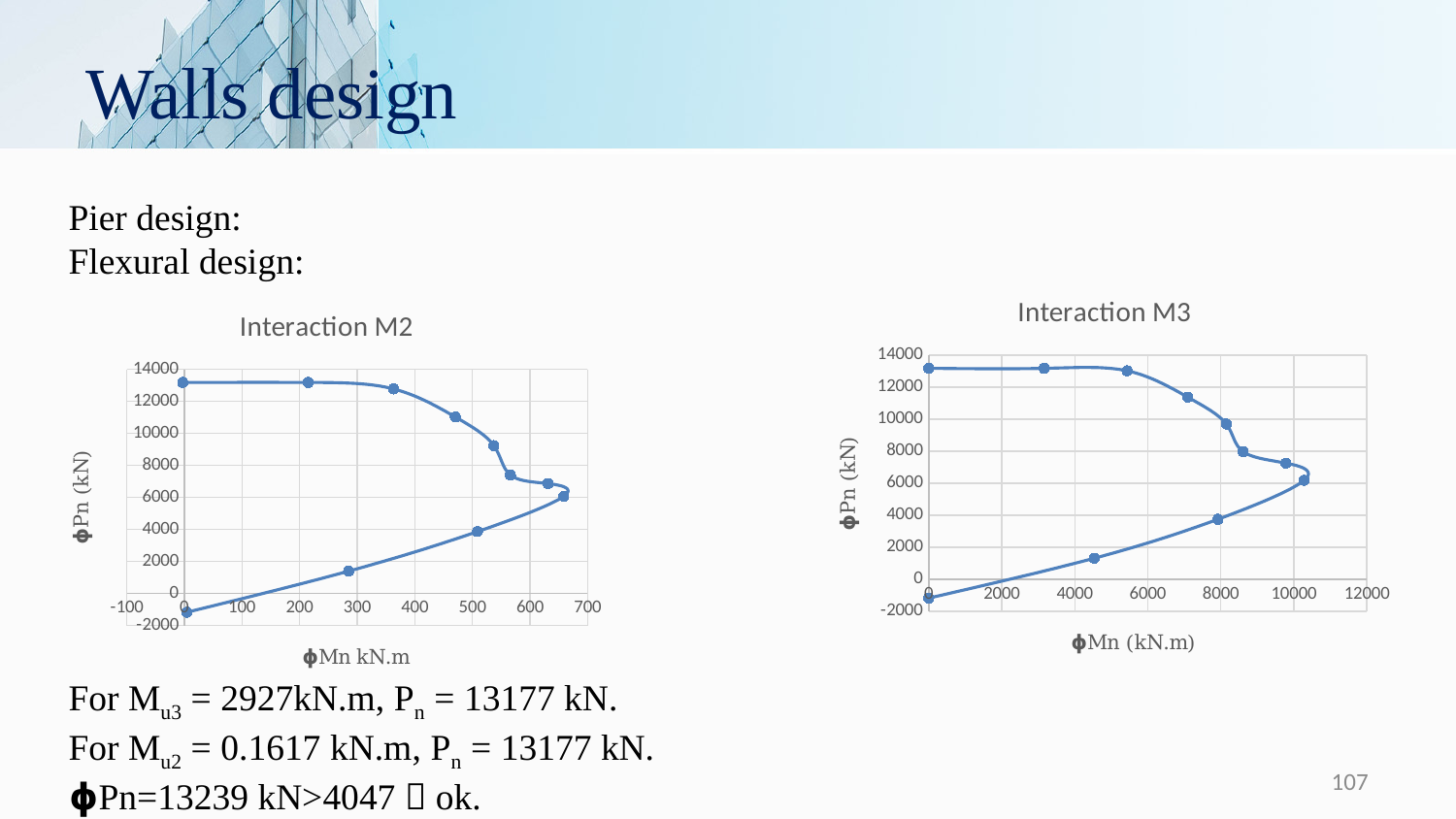
What is the y-axis title of the Interaction M3 chart? ϕPn (kN) In the Interaction M3 chart, is the ϕPn value at the point with the largest ϕMn greater or less than 4000? greater In the Interaction M3 chart, is the largest ϕMn value reached by the curve greater or less than 8000? greater In the Interaction M2 chart, is the lowest ϕPn value on the curve greater or less than 0? less What is the title of the chart on the left side of the slide? Interaction M2 Which chart reaches a larger maximum ϕMn value, Interaction M2 or Interaction M3? Interaction M3 What type of chart is the Interaction M2 chart? line chart What type of chart is the Interaction M3 chart? line chart